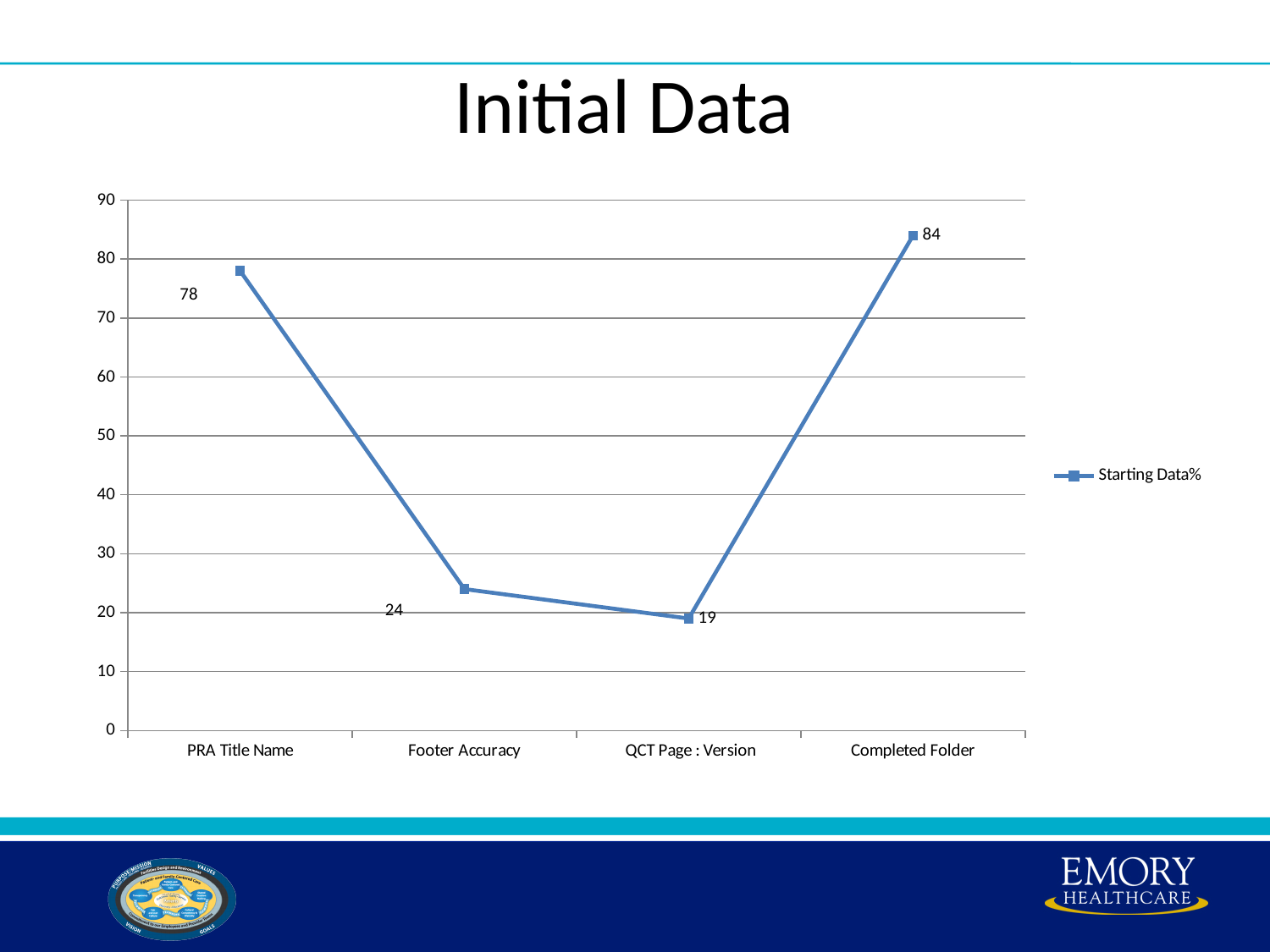
What is the Starting Data% value for QCT Page : Version? 19 What is the name of the series shown in the legend? Starting Data% Which is larger, the value for PRA Title Name or the value for Footer Accuracy? PRA Title Name What type of chart is shown on the slide? Line chart What is the Starting Data% value for PRA Title Name? 78 Which category has the lowest Starting Data% value? QCT Page : Version What is the Starting Data% value for Completed Folder? 84 What is the difference between the Completed Folder value and the PRA Title Name value? 6 Which category has the highest Starting Data% value? Completed Folder How many categories are plotted on the x axis? 4 What is the Starting Data% value for Footer Accuracy? 24 What is the difference between the Footer Accuracy value and the QCT Page : Version value? 5